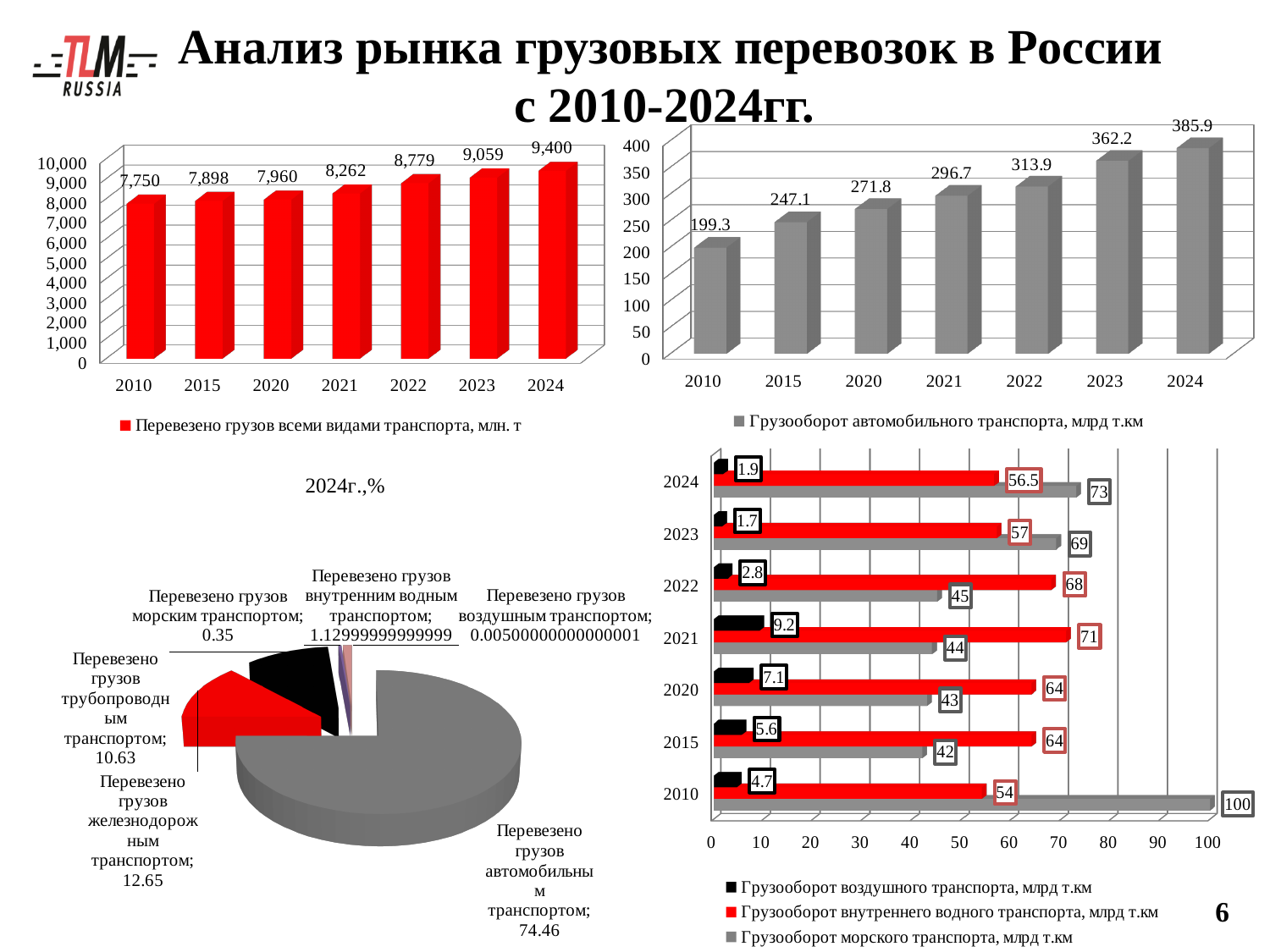
In the top-left chart (Перевезено грузов всеми видами транспорта, млн. т), do the values rise or fall from 2010 to 2024? rise How many years are plotted in the top-right chart (Грузооборот автомобильного транспорта, млрд т.км)? 7 In the pie chart titled 2024г.,%, which is larger: Перевезено грузов железнодорожным транспортом or Перевезено грузов трубопроводным транспортом? Перевезено грузов железнодорожным транспортом In the pie chart titled 2024г.,%, what share is Перевезено грузов автомобильным транспортом? 74.46 How many series does the legend of the bottom-right horizontal bar chart list? 3 In the top-right chart (Грузооборот автомобильного транспорта, млрд т.км), which year has the highest value? 2024 In the top-left chart (Перевезено грузов всеми видами транспорта, млн. т), what is the value for 2022? 8,779 In the bottom-right chart, what is the value of Грузооборот морского транспорта, млрд т.км for 2010? 100 In the top-right chart (Грузооборот автомобильного транспорта, млрд т.км), what is the value for 2023? 362.2 In the bottom-right chart, what is the difference between Грузооборот внутреннего водного транспорта and Грузооборот морского транспорта for 2021? 27 What kind of chart is the top-left chart (Перевезено грузов всеми видами транспорта, млн. т)? bar chart In the top-left chart (Перевезено грузов всеми видами транспорта, млн. т), what is the difference between the 2024 and 2010 values? 1,650